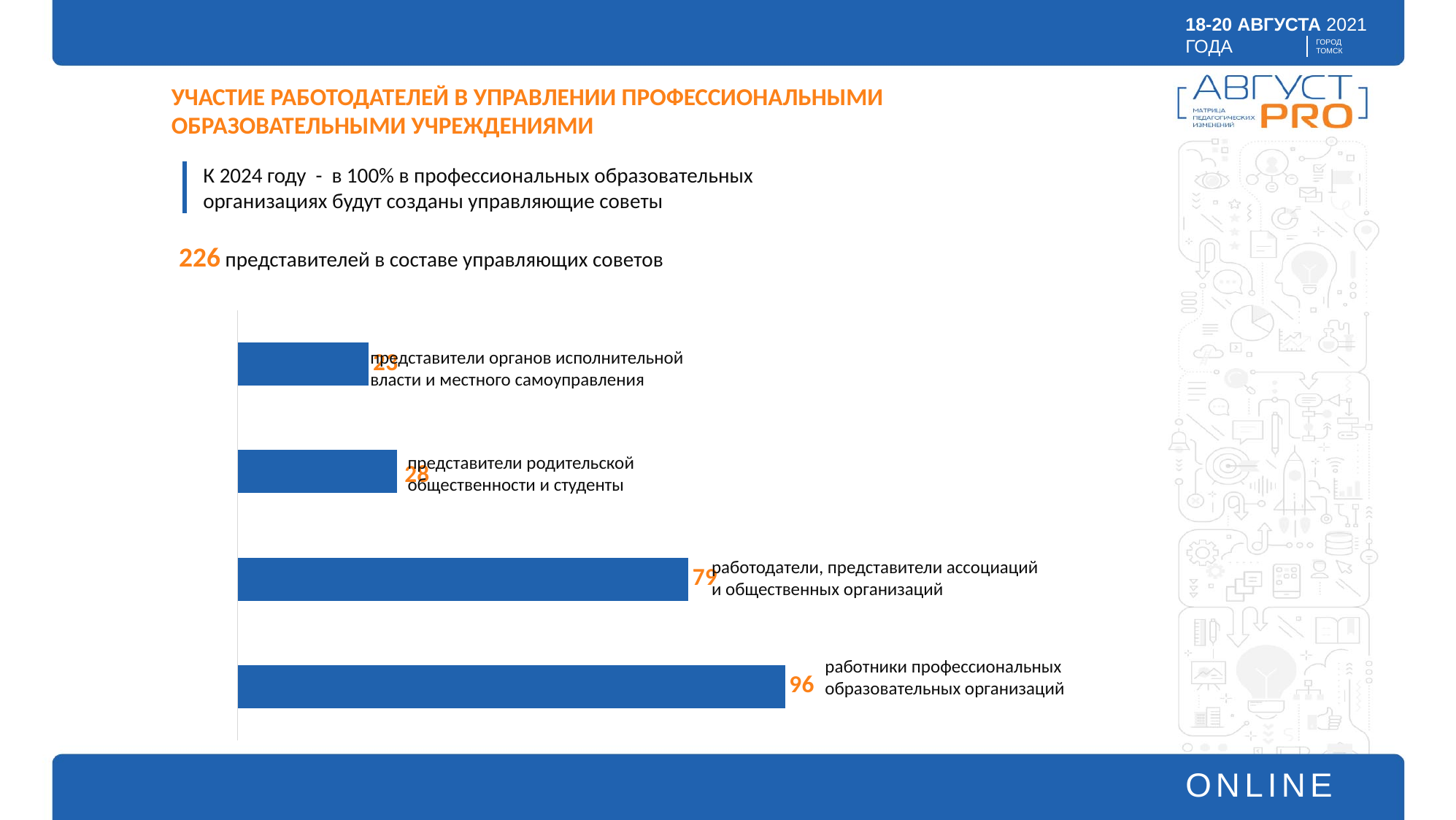
Which category has the lowest value? представители органов исполнительной власти и местного самоуправления What is the value for представители органов исполнительной власти и местного самоуправления? 23 What is the value for работодатели, представители ассоциаций и общественных организаций? 79 How many bars (categories) does the chart show? 4 What is the total of all four bar values in the chart? 226 What is the value for представители родительской общественности и студенты? 28 Which category has the highest value? работники профессиональных образовательных организаций What colour are the bars in the chart? blue What is the value for работники профессиональных образовательных организаций? 96 What kind of chart is shown on the slide? bar chart What is the difference between the values for работники профессиональных образовательных организаций and работодатели, представители ассоциаций и общественных организаций? 17 Which is larger: the value for представители родительской общественности и студенты or the value for представители органов исполнительной власти и местного самоуправления? представители родительской общественности и студенты